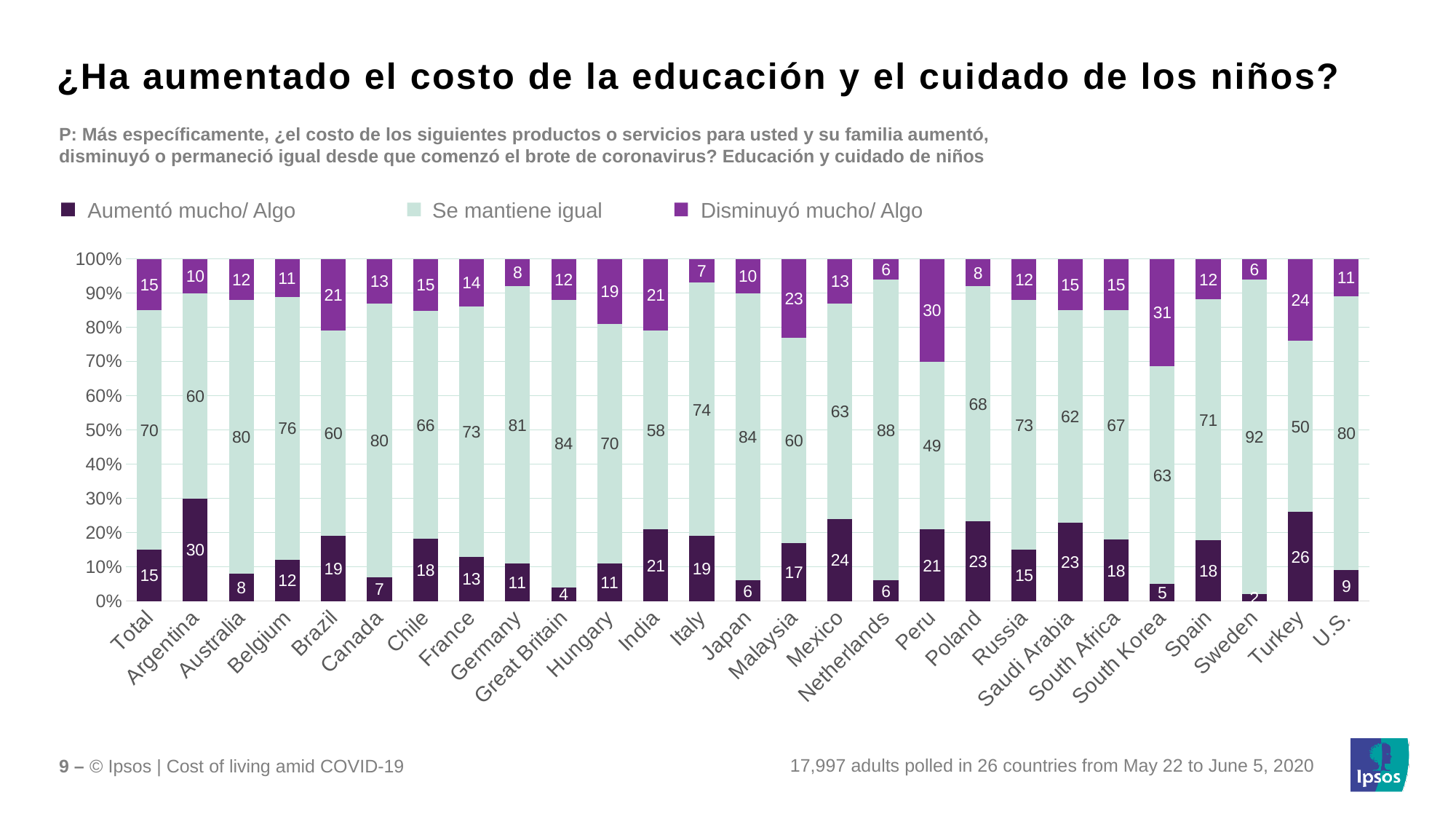
Which is larger, the 'Disminuyó mucho/ Algo' value for Turkey or for Brazil? Turkey How many countries/categories are shown along the x axis? 27 What is the value of 'Aumentó mucho/ Algo' for Argentina? 30 Which legend entry is shown in the lightest colour? Se mantiene igual How many series does the legend list? 3 What kind of chart is shown on the slide? Stacked bar chart Which country has the lowest value for 'Aumentó mucho/ Algo'? Sweden Which country has the highest value for 'Aumentó mucho/ Algo'? Argentina What is the value of 'Disminuyó mucho/ Algo' for South Korea? 31 What is the value of 'Se mantiene igual' for Peru? 49 Which country has the highest value for 'Se mantiene igual'? Sweden What is the difference between the 'Aumentó mucho/ Algo' values for Mexico and Canada? 17